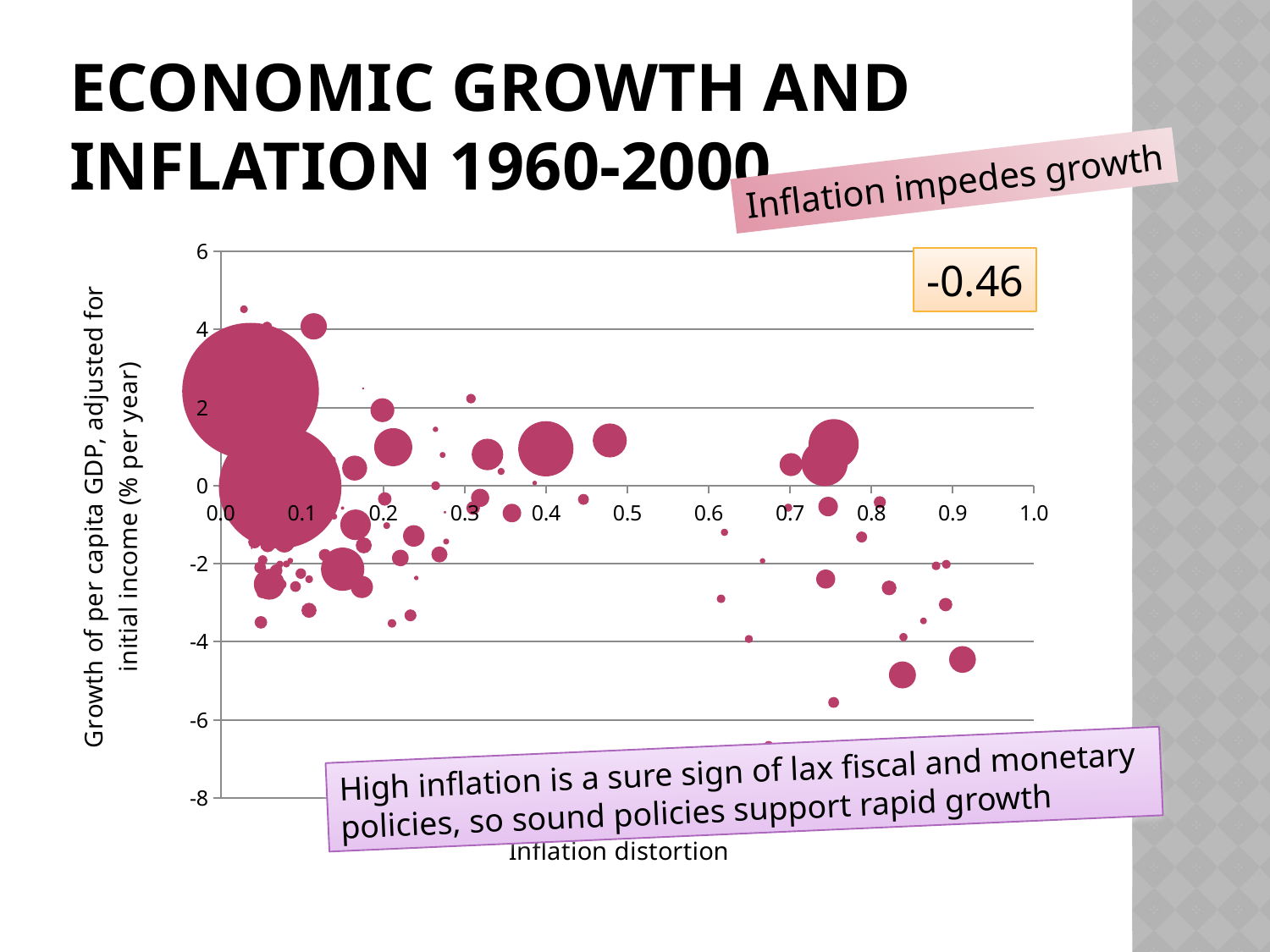
What number is shown in the box at the top right of the chart? -0.46 Is the inflation distortion of the lowest bubble on the chart greater or less than 0.6? greater What is the highest tick value shown on the y axis of the chart? 6 Is the inflation distortion of the largest bubble on the chart greater or less than 0.2? less Is the growth value of the highest bubble on the chart greater or less than 4? greater As inflation distortion increases along the x axis, does growth of per capita GDP tend to rise or fall? Fall What kind of chart is shown on the slide? Bubble chart What is the title of the x axis of the chart? Inflation distortion